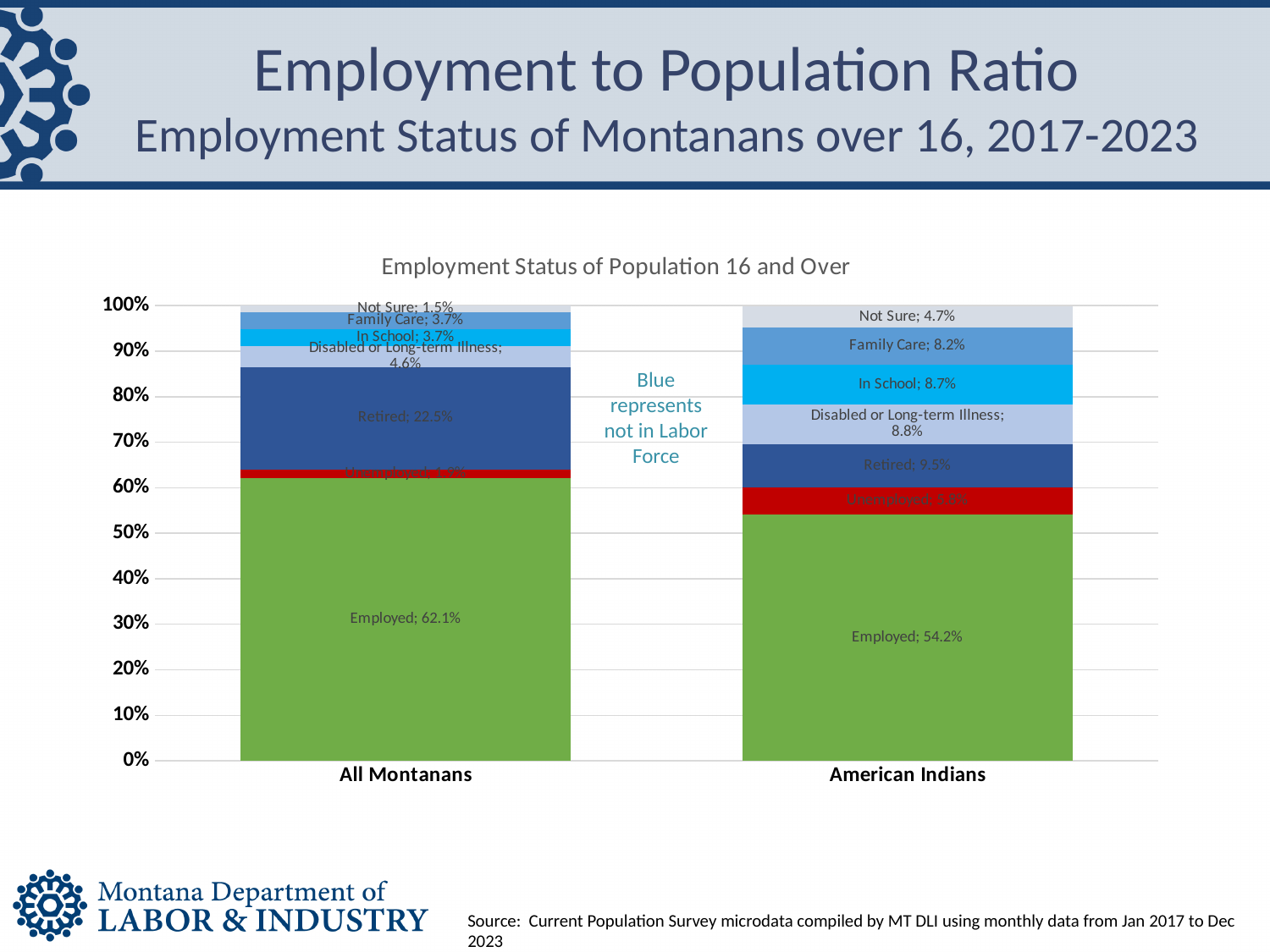
Which group has the larger Retired share, All Montanans or American Indians? All Montanans What is the Employed share for All Montanans? 62.1% What is the title of the chart? Employment Status of Population 16 and Over What is the Employed share for American Indians? 54.2% What is the Family Care share for American Indians? 8.2% How many percentage points higher is the Employed share for All Montanans than for American Indians? 7.9 percentage points What is the Retired share for All Montanans? 22.5% What kind of chart is shown on the slide? Stacked bar chart What is the Retired share for American Indians? 9.5% What is the Not Sure share for American Indians? 4.7% How many groups are shown on the x axis? 2 What is the Disabled or Long-term Illness share for All Montanans? 4.6%